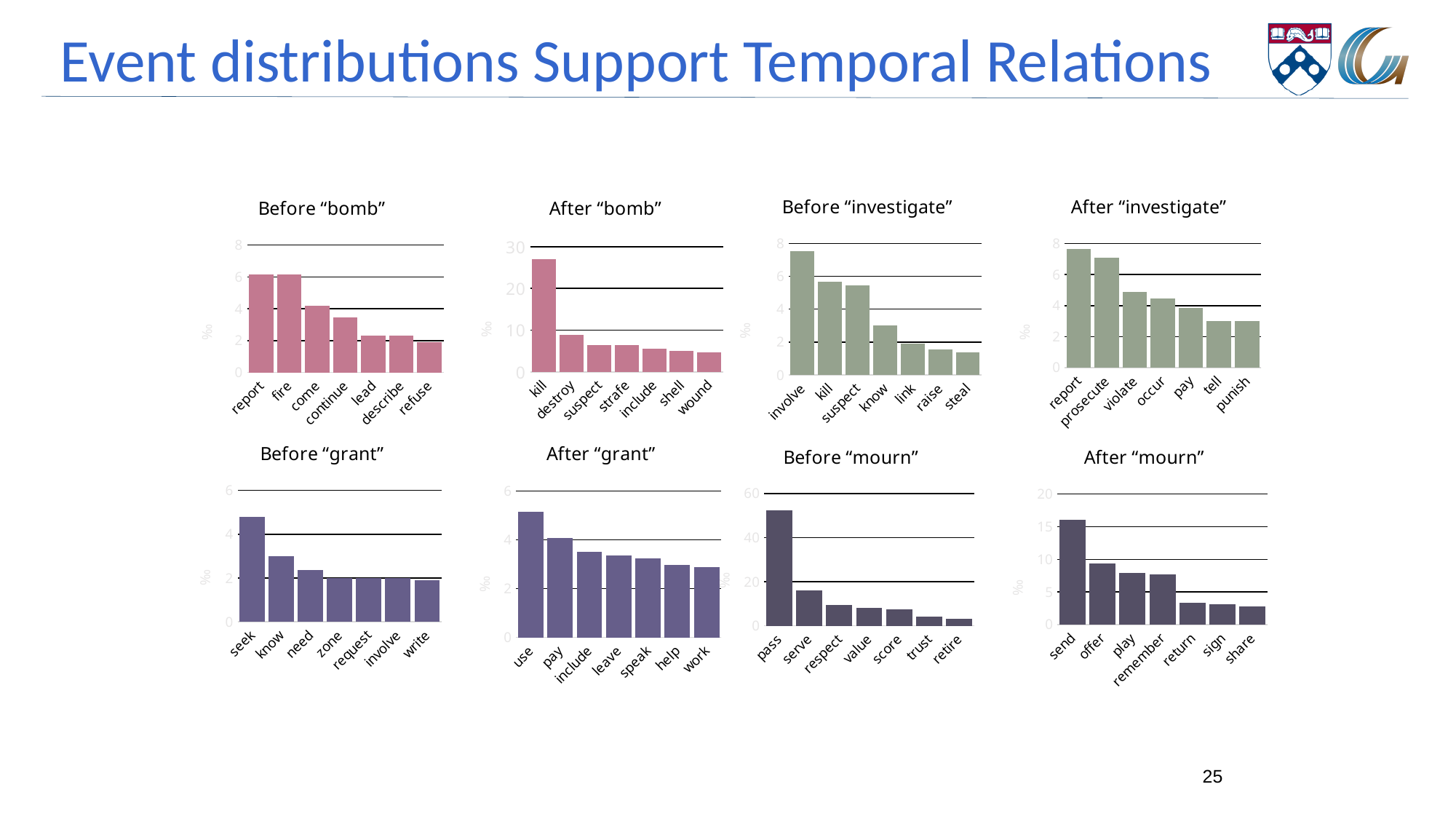
In the "Before “grant”" chart, is the value for seek greater or less than 4? greater In the "After “grant”" chart, do the values rise or fall from left to right along the x axis? fall In the "After “grant”" chart, which category has the highest value? use In the "Before “investigate”" chart, is the value for know greater or less than 4? less In the "Before “mourn”" chart, is the value for serve greater or less than 20? less In the "Before “mourn”" chart, which is larger, the value for pass or the value for serve? pass What kind of chart is the "After “investigate”" chart? bar chart How many categories are shown in the "Before “bomb”" chart? 7 In the "After “bomb”" chart, which category has the highest value? kill In the "Before “investigate”" chart, which category has the highest value? involve